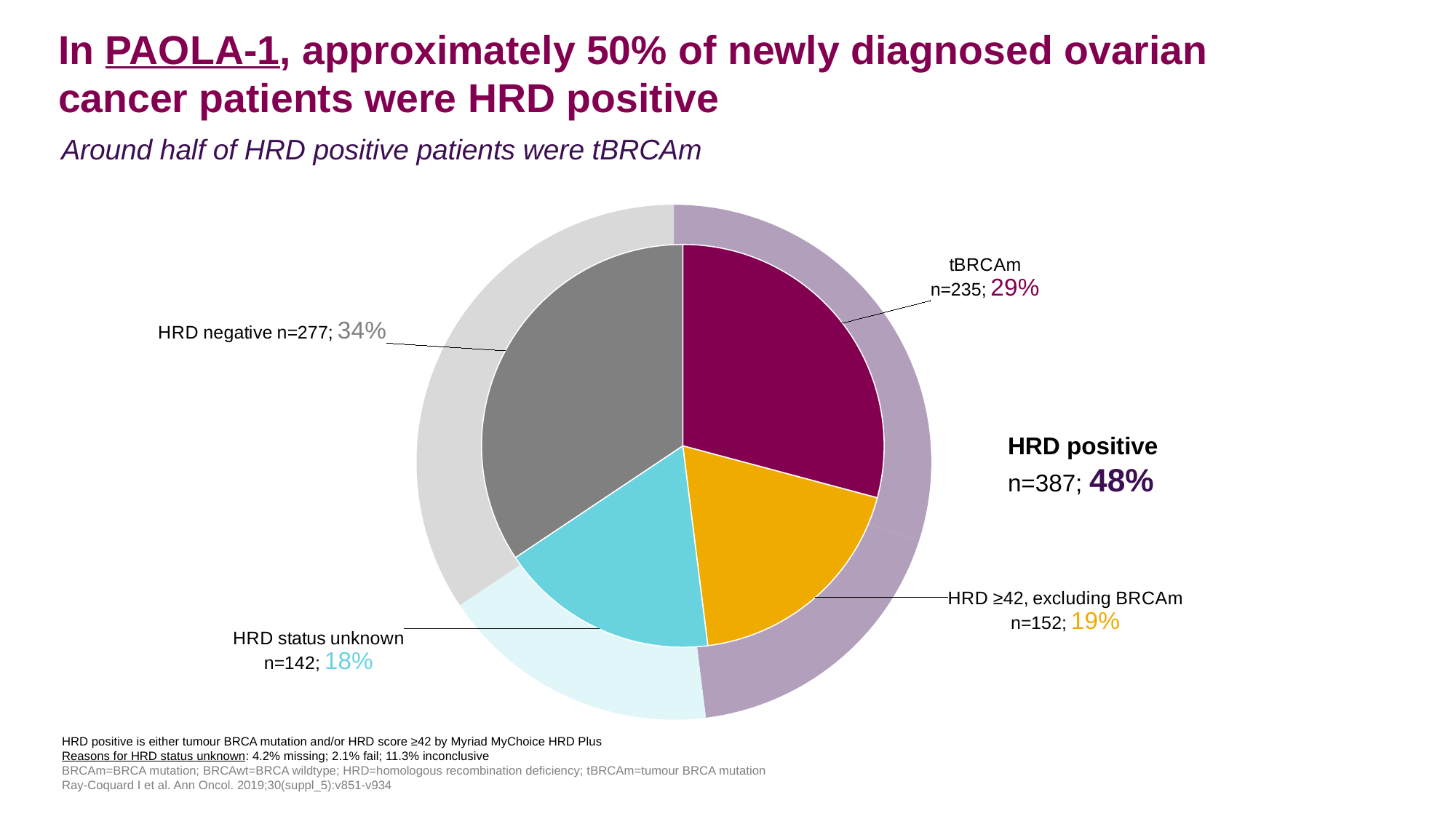
Which slice of the pie chart is the largest? HRD negative What is the n value for the HRD ≥42, excluding BRCAm slice? 152 What percentage of patients had HRD status unknown? 18% What percentage of patients were HRD positive according to the outer ring? 48% What colour is the tBRCAm slice of the pie chart? Dark purple How many patients were HRD negative (n)? 277 Which is larger, the tBRCAm slice or the HRD ≥42, excluding BRCAm slice? tBRCAm What percentage of patients were tBRCAm? 29% Which slice of the pie chart is the smallest? HRD status unknown What kind of chart is shown on the slide? Pie chart How many slices does the inner pie chart have? 4 What is the difference in percentage points between the HRD negative slice and the tBRCAm slice? 5